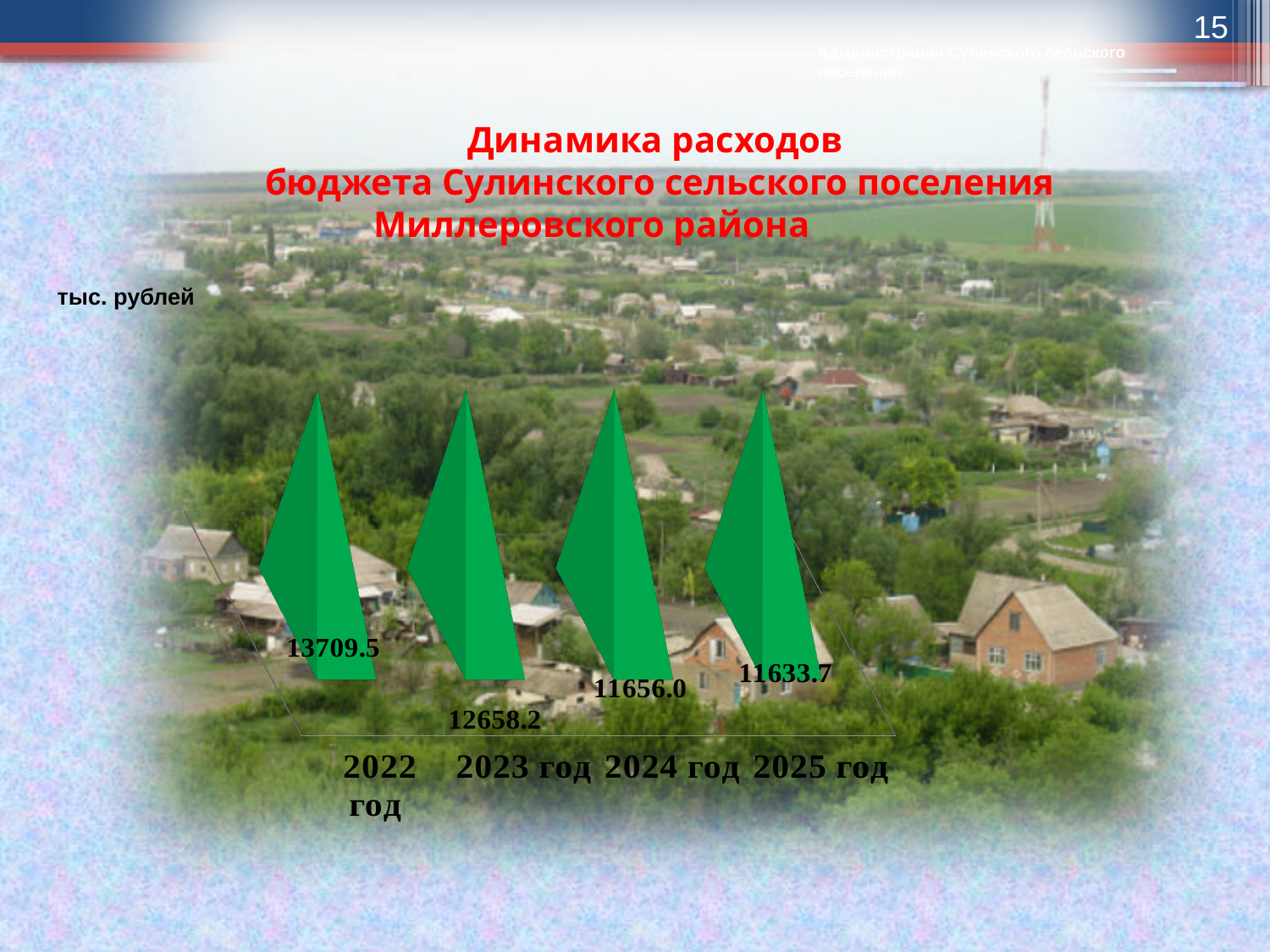
Which year has the highest expenditure value? 2022 год What is the value shown for 2025 год? 11633.7 Do the values rise or fall from 2022 год to 2025 год? fall What is the difference between the values for 2022 год and 2023 год? 1051.3 What is the value shown for 2024 год? 11656.0 Which is larger, the value for 2023 год or the value for 2024 год? 2023 год What is the difference between the values for 2022 год and 2025 год? 2075.8 How many years are shown on the chart? 4 Which year has the lowest expenditure value? 2025 год In what units are the chart values expressed? тыс. рублей What is the value shown for 2023 год? 12658.2 What is the budget expenditure value shown for 2022 год? 13709.5